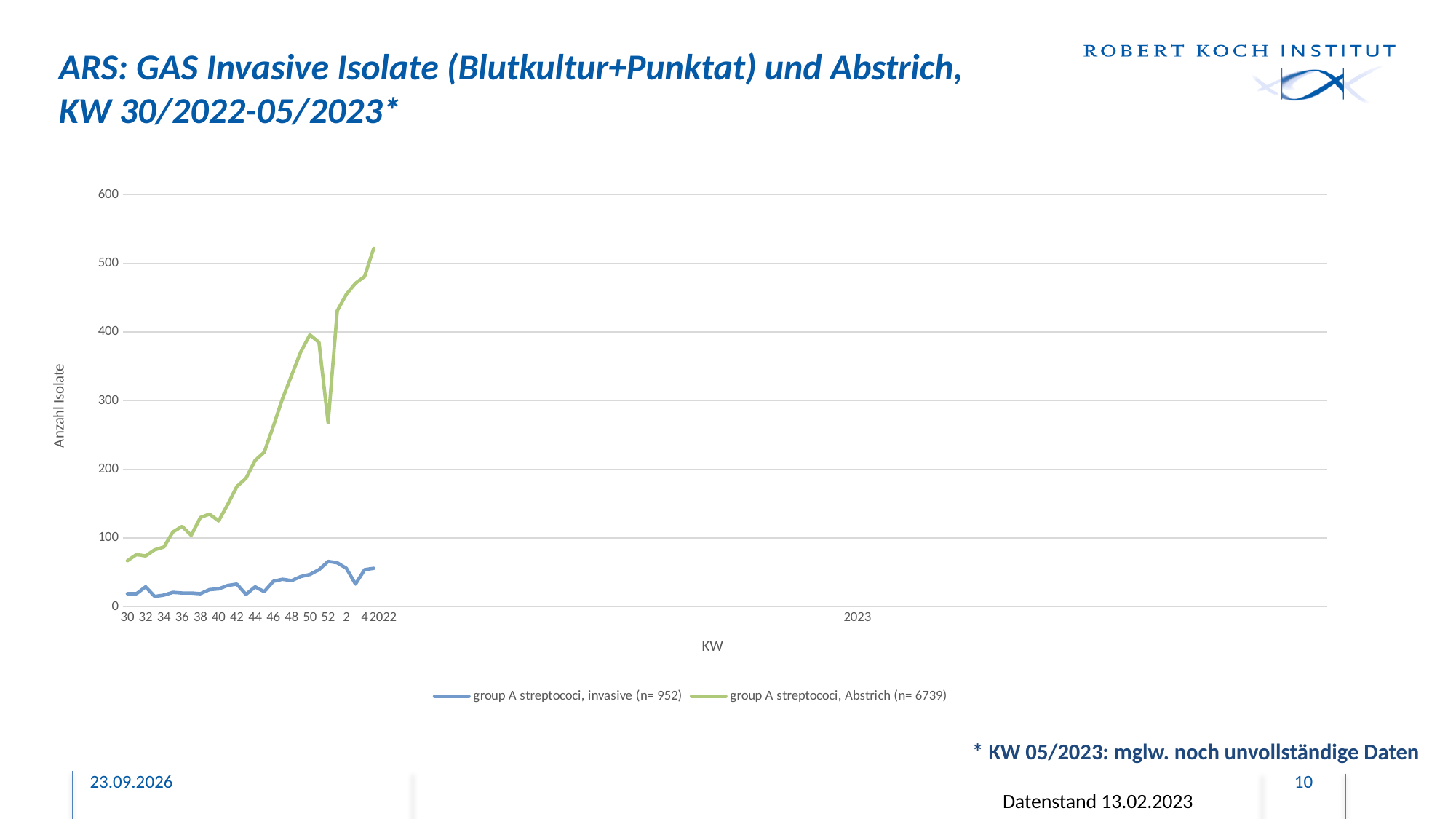
Is the value for group A streptococi, Abstrich at KW 50 greater or less than 300? greater Is the value for group A streptococi, invasive at KW 50 greater or less than 100? less Does the group A streptococi, Abstrich series overall rise or fall from KW 30/2022 to KW 4/2023? rise What is the label of the y axis? Anzahl Isolate What is the label of the x axis? KW Which series reaches the highest value on the chart? group A streptococi, Abstrich Which series has the higher value at KW 4/2023, invasive or Abstrich? group A streptococi, Abstrich Is the value for group A streptococi, Abstrich at KW 30 greater or less than 100? less How many series does the legend list? 2 What kind of chart is shown on the slide? line chart